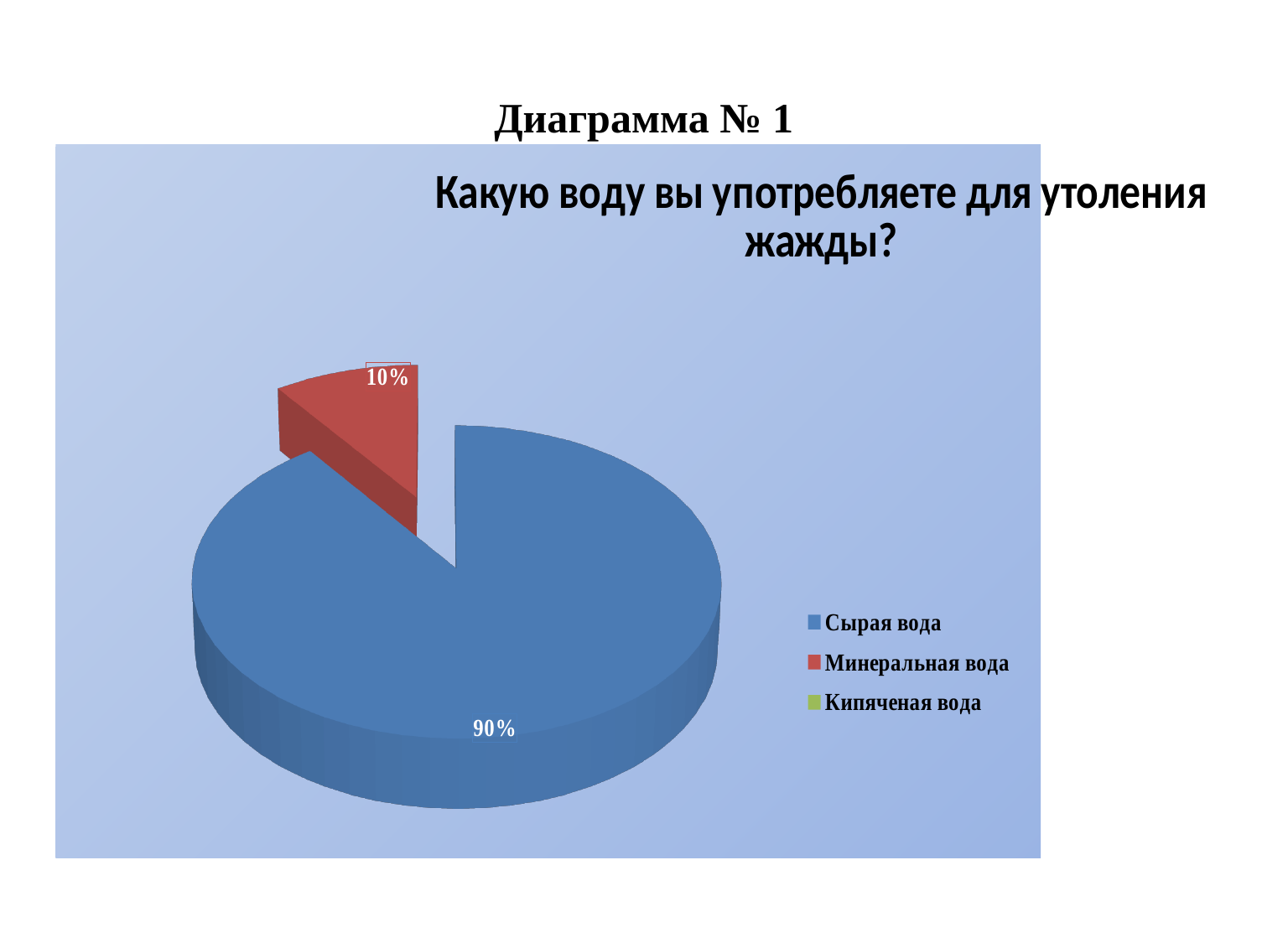
Is the value for Сырая вода greater or less than 50%? greater Which is larger, the slice for Сырая вода or the slice for Минеральная вода? Сырая вода What kind of chart is shown on the slide? Pie chart How many entries does the chart legend list? 3 What colour is the slice for Минеральная вода? Red Which category has the largest slice of the pie? Сырая вода What is the difference in percentage points between the Сырая вода slice and the Минеральная вода slice? 80 percentage points How many categories are listed in the legend of the chart? 3 What percentage of the pie is labelled for Сырая вода? 90% What is the title of the chart? Какую воду вы употребляете для утоления жажды? What percentage of the pie is labelled for Минеральная вода? 10% What share of the pie does Сырая вода take? 90%